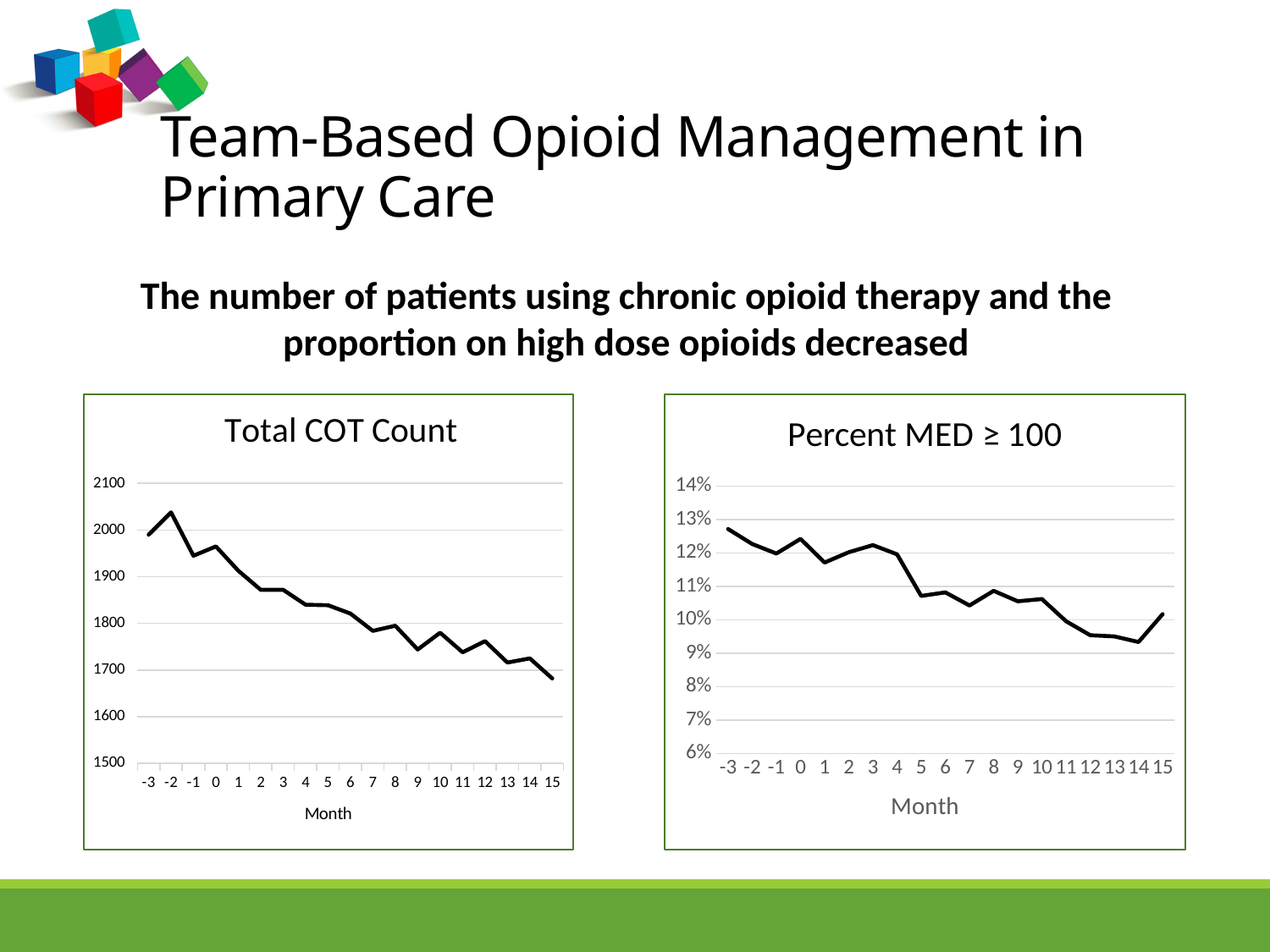
In the "Total COT Count" chart, is the value for month 15 greater or less than 1700? less In the "Percent MED ≥ 100" chart, which month has the highest value? -3 In the "Total COT Count" chart, do the values generally rise or fall from month -3 to month 15? fall In the "Percent MED ≥ 100" chart, is the value for month 14 greater or less than 10%? less In the "Percent MED ≥ 100" chart, do the values generally rise or fall from month -3 to month 15? fall In the "Total COT Count" chart, how many months are plotted along the x axis? 19 In the "Total COT Count" chart, is the value for month -2 greater or less than 2000? greater What is the x-axis label on the "Percent MED ≥ 100" chart? Month In the "Total COT Count" chart, which month has the lowest value? 15 In the "Total COT Count" chart, which month has the highest value? -2 What kind of chart is the "Total COT Count" chart? line chart What kind of chart is the "Percent MED ≥ 100" chart? line chart